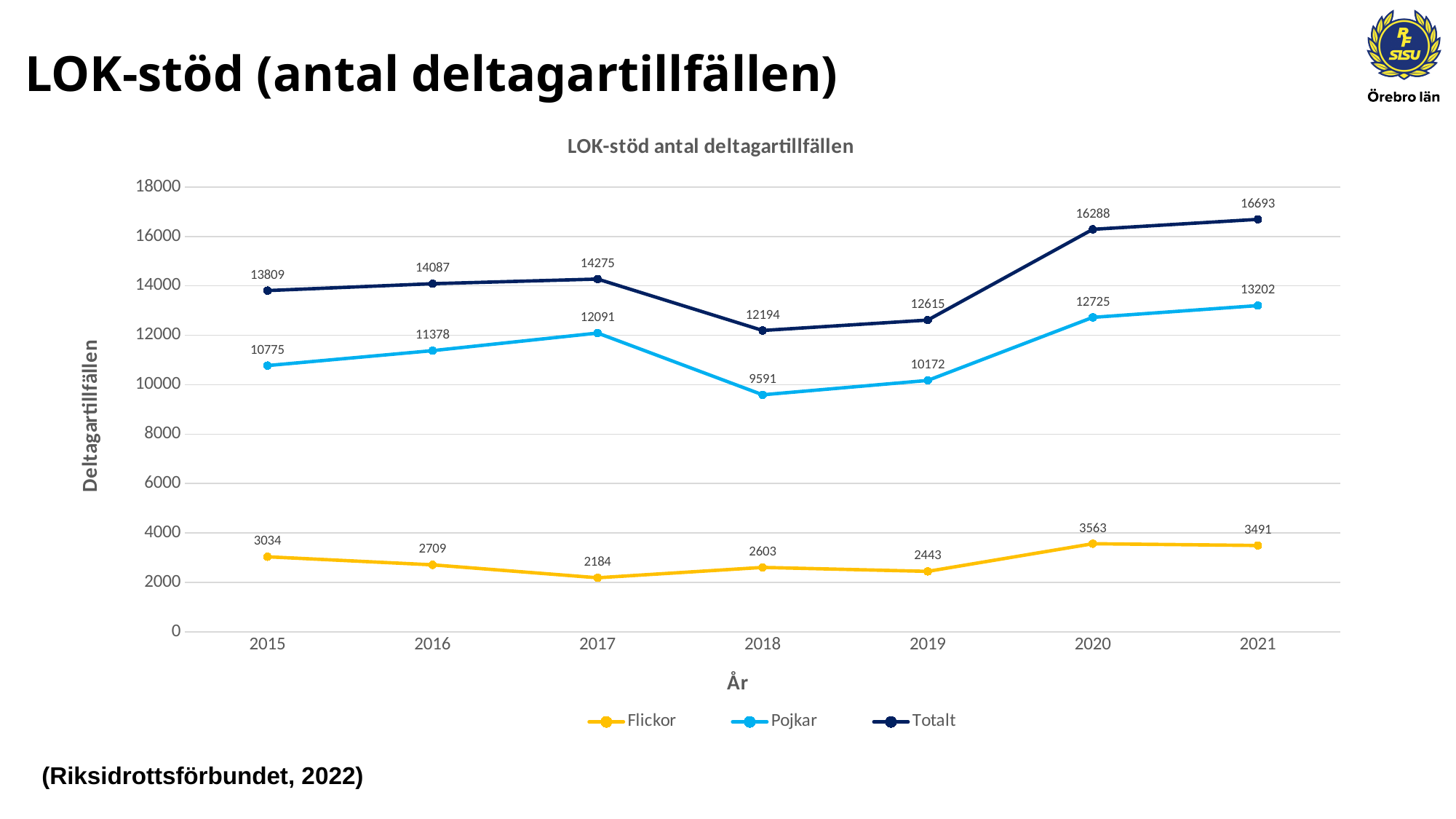
How many series does the legend list? 3 In which year is the Totalt series highest? 2021 Which is larger, the Pojkar value in 2017 or the Pojkar value in 2019? 2017 What is the value for Totalt in 2021? 16693 What kind of chart is shown? line chart What is the difference between the Totalt values for 2020 and 2019? 3673 In which year is the Flickor series lowest? 2017 How many years are shown on the x axis? 7 What is the value for Flickor in 2017? 2184 What is the value for Pojkar in 2018? 9591 What is the title of the chart? LOK-stöd antal deltagartillfällen Is the value for Pojkar in 2020 greater or less than 12000? greater